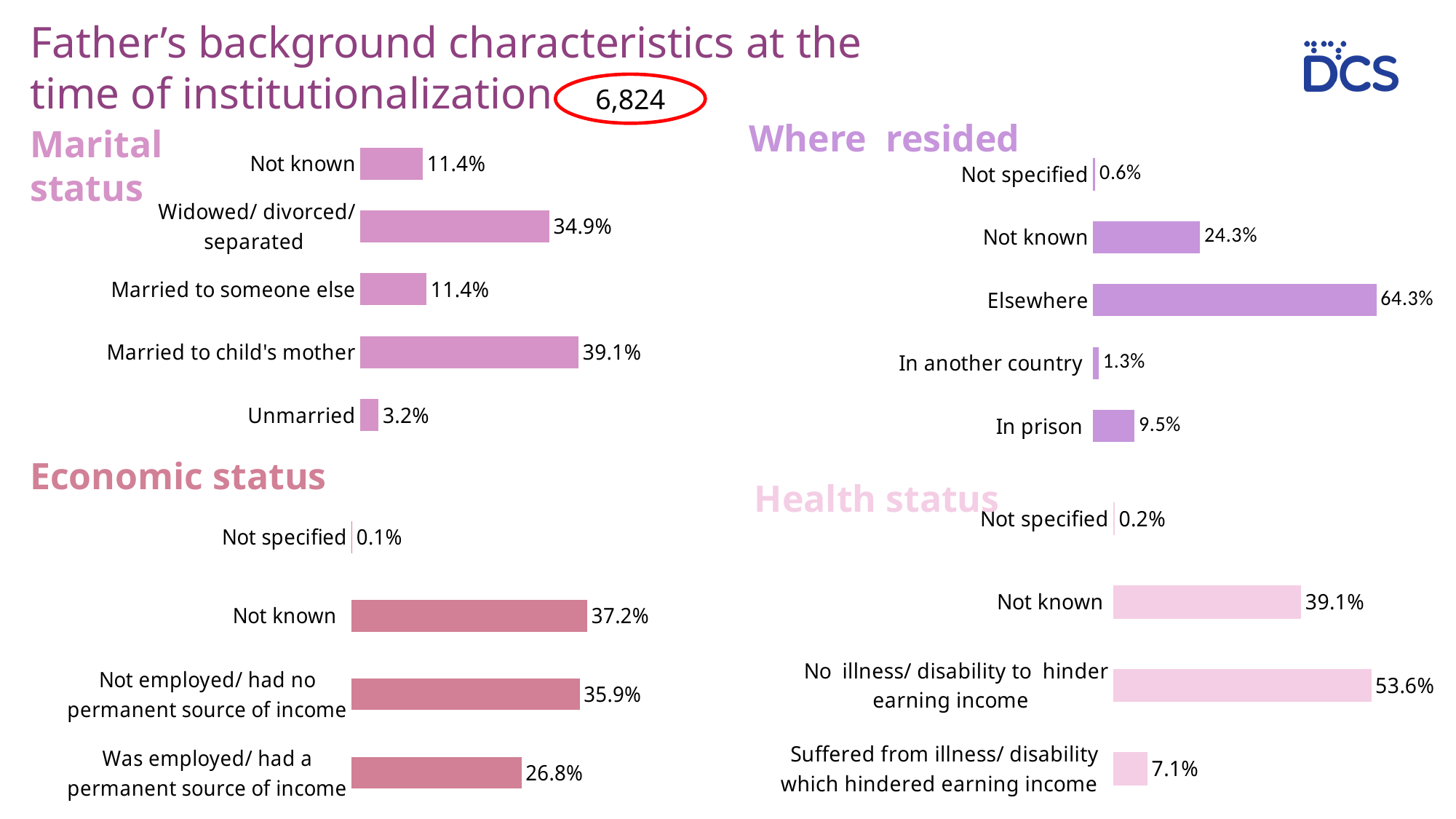
In the Health status chart, which category has the highest value? No illness/ disability to hinder earning income What kind of chart is the Health status chart? Bar chart In the Marital status chart, what is the value for Married to child's mother? 39.1% In the Health status chart, what is the value for Suffered from illness/ disability which hindered earning income? 7.1% In the Marital status chart, what is the difference between Married to child's mother and Widowed/ divorced/ separated? 4.2% In the Where resided chart, what is the value for Elsewhere? 64.3% In the Economic status chart, what is the value for Was employed/ had a permanent source of income? 26.8% In the Economic status chart, which is larger: Not known or Not employed/ had no permanent source of income? Not known In the Where resided chart, how many categories are shown? 5 In the Economic status chart, what is the difference between Not known and Was employed/ had a permanent source of income? 10.4% In the Where resided chart, which category has the highest value? Elsewhere In the Marital status chart, which category has the lowest value? Unmarried